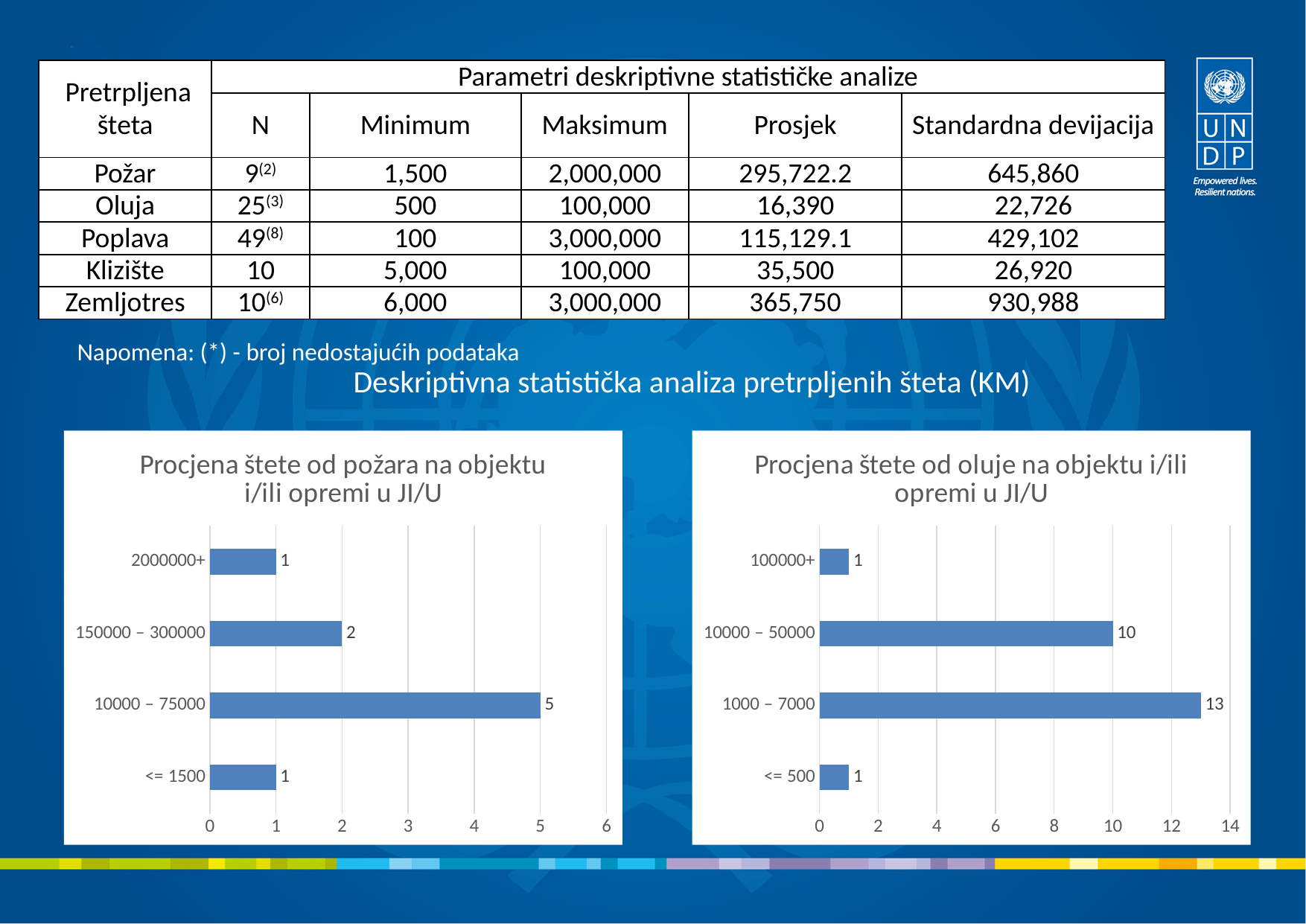
In the right chart (Procjena štete od oluje), what is the highest value shown on the x axis? 14 In the left chart (Procjena štete od požara), how many categories are shown? 4 What type of chart is the right chart (Procjena štete od oluje)? Bar chart In the right chart (Procjena štete od oluje), which is larger: the value for 10000 – 50000 or the value for 100000+? 10000 – 50000 In the left chart (Procjena štete od požara), which category has the highest value? 10000 – 75000 In the left chart (Procjena štete od požara na objektu i/ili opremi u JI/U), what is the value for the 10000 – 75000 category? 5 In the right chart (Procjena štete od oluje), what is the value for the 10000 – 50000 category? 10 In the right chart (Procjena štete od oluje), which category has the highest value? 1000 – 7000 In the right chart (Procjena štete od oluje), what is the difference between the 1000 – 7000 value and the 10000 – 50000 value? 3 In the right chart (Procjena štete od oluje na objektu i/ili opremi u JI/U), what is the value for the 1000 – 7000 category? 13 In the left chart (Procjena štete od požara), what is the value for the 150000 – 300000 category? 2 In the left chart (Procjena štete od požara), what is the difference between the 10000 – 75000 value and the 150000 – 300000 value? 3